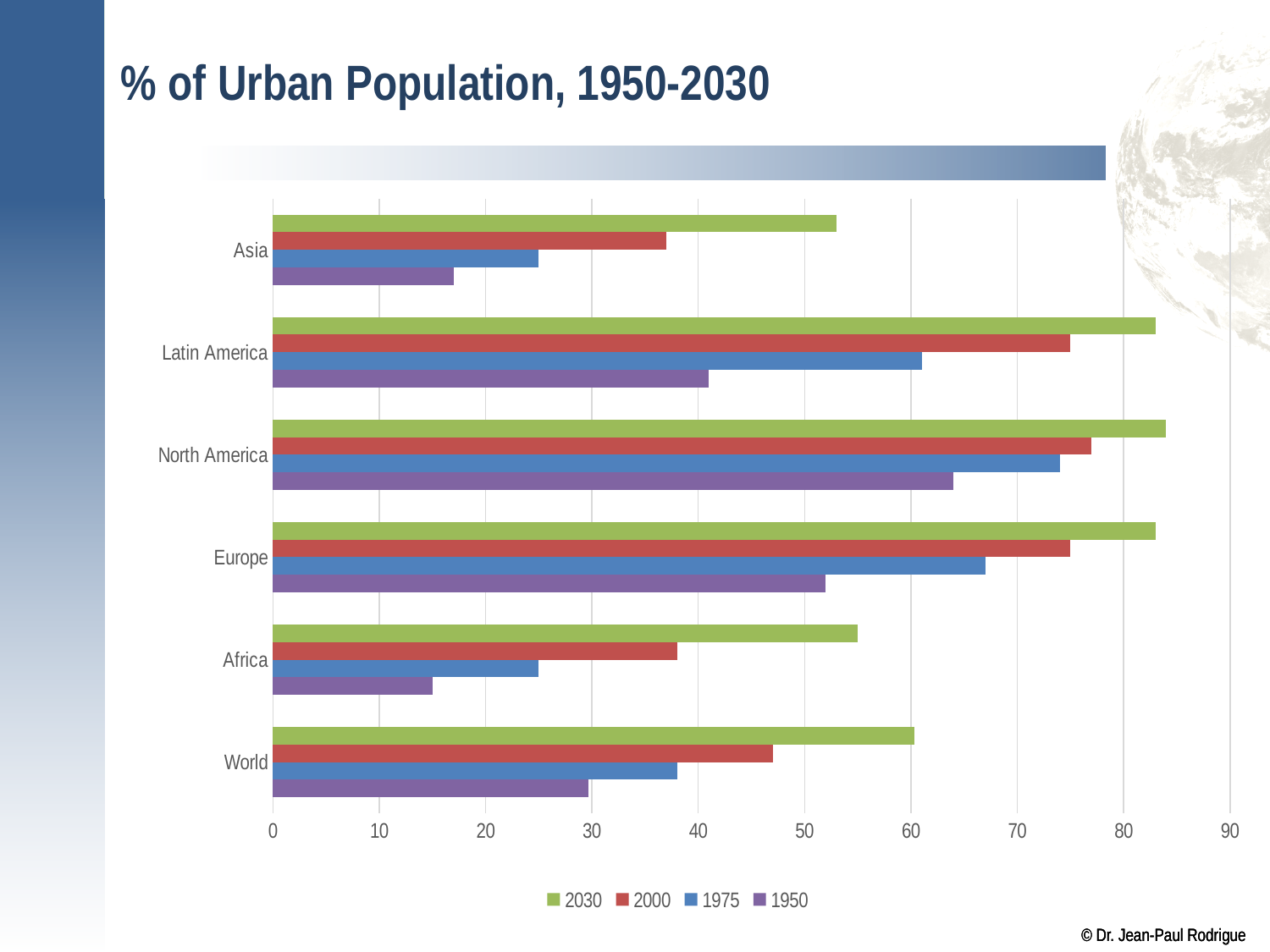
Is the 1950 value for North America greater or less than 60? greater Which region has the highest 1950 value? North America Do the values for Africa increase or decrease from 1950 to 2030? increase What kind of chart is shown on the slide? bar chart How many series does the legend list? 4 Which is larger, the 1950 value for Europe or the 1950 value for Latin America? Europe How many regions/categories are shown on the chart? 6 Is the 1950 value for Asia greater or less than 20? less Is the 1975 value for Europe greater or less than 60? greater Which year does the green series represent in the legend? 2030 What is the title of the chart? % of Urban Population, 1950-2030